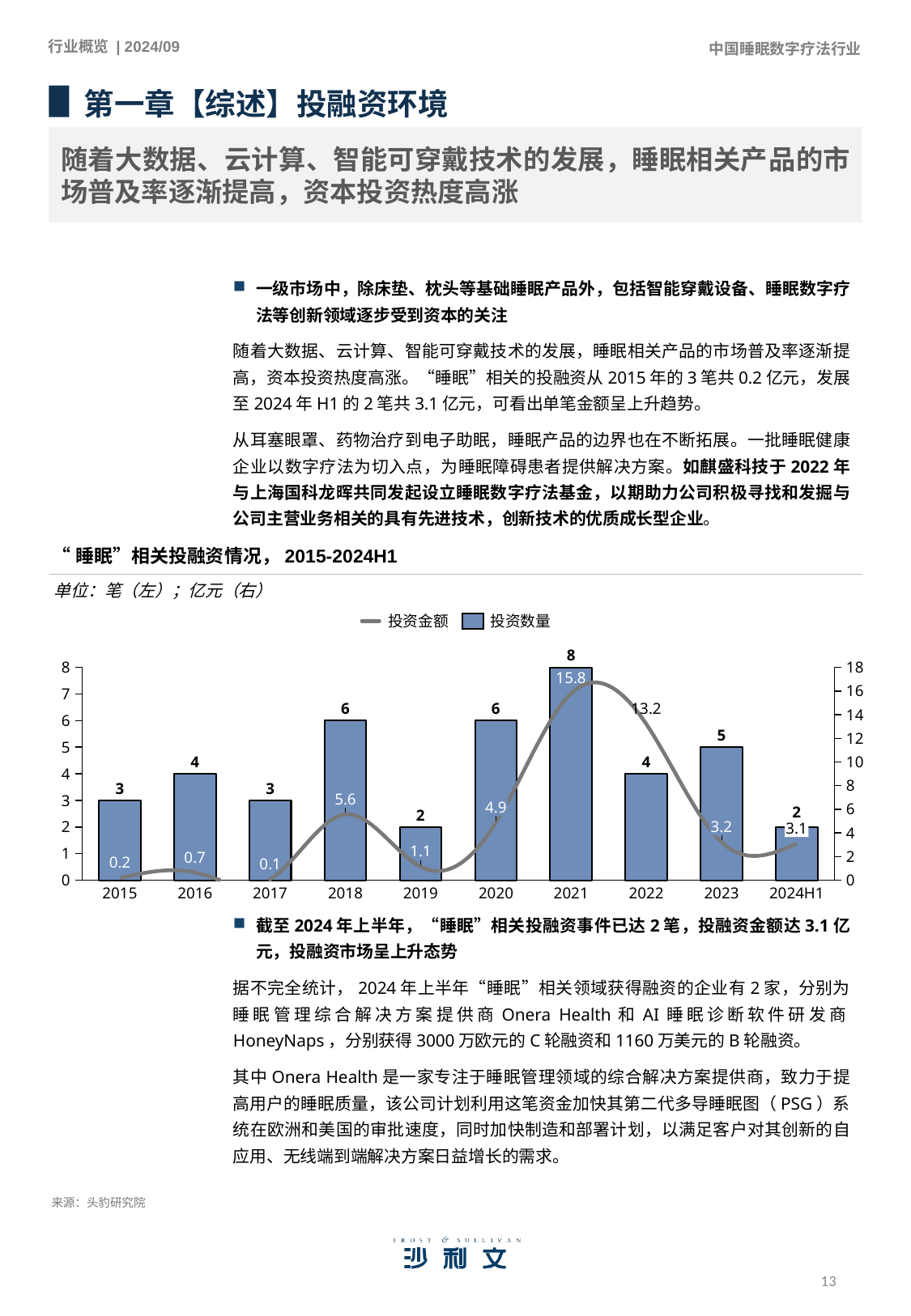
图表中投资数量是用什么类型的图表表示的？ 柱状图（条形图） 图表中2021年的投资数量是多少笔？ 8 图表中投资金额从2021年到2023年呈上升还是下降趋势？ 下降 图表中2023年与2024H1的投资数量相差多少笔？ 3 图表中横轴共有多少个时间类别？ 10 图表的图例中列出了多少个系列？ 2 图表中2024H1的投资金额是多少亿元？ 3.1 图表中哪一年的投资金额最低？ 2017 图表中2020年和2022年，哪一年的投资数量更多？ 2020 图表中哪一年的投资金额最高？ 2021 图表中2021年与2022年的投资金额相差多少亿元？ 2.6 图表中2018年的投资金额是多少亿元？ 5.6